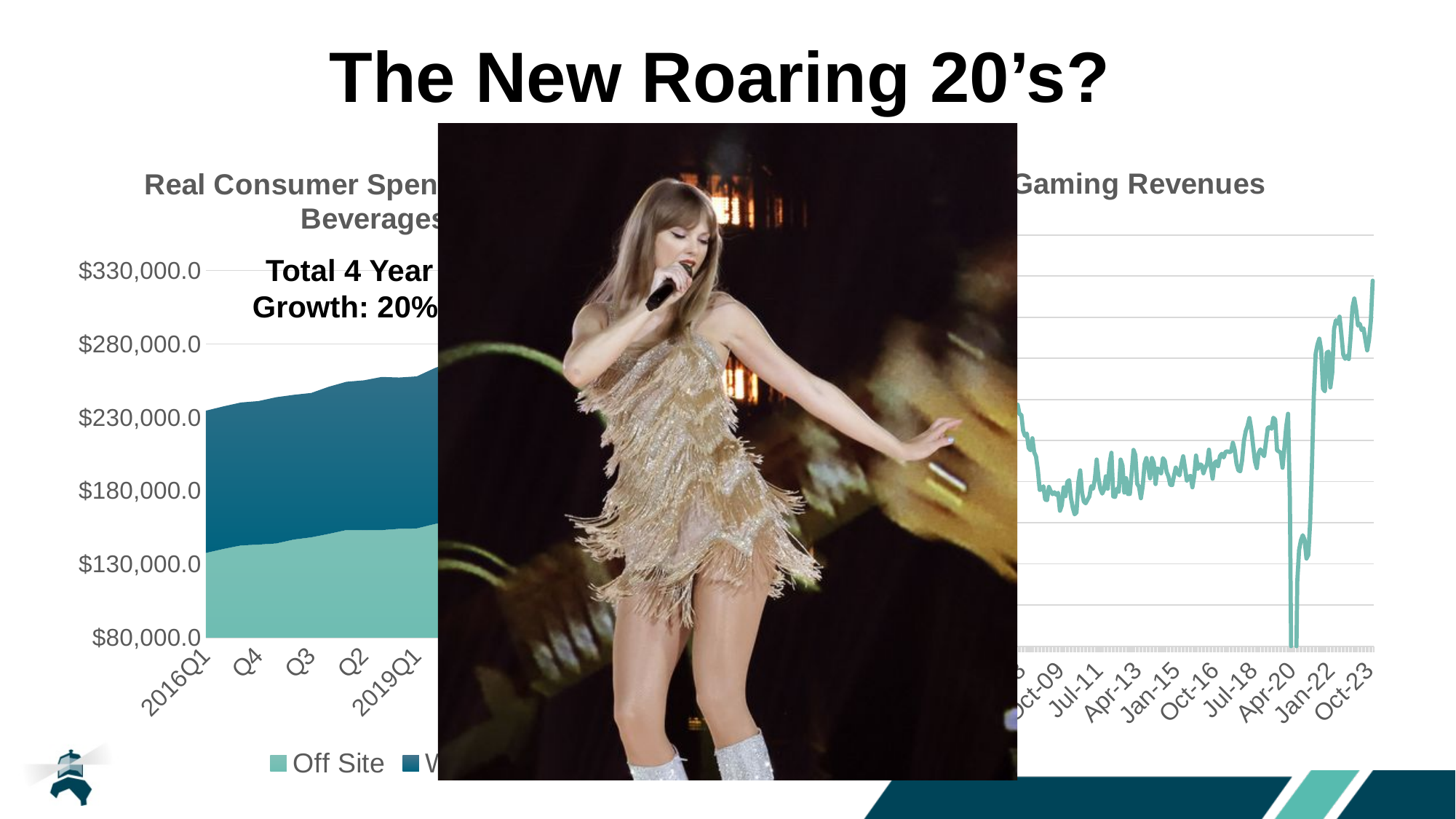
What kind of chart is the right chart (Gaming Revenues)? line chart On the right chart, does the line rise or fall sharply around Apr-20? fall What kind of chart is the left chart (Real Consumer Spending)? area chart On the right chart, does the line rise or fall from Apr-20 to Oct-23? rise On the left chart, what is the first legend entry shown? Off Site On the left chart, which is larger: the Off Site value at 2016Q1 or at 2019Q1? 2019Q1 On the left chart, is the Off Site value at 2016Q1 greater or less than $130,000.0? greater On the left chart, is the total stacked value at 2016Q1 greater or less than $280,000.0? less On the right chart, which is larger: the value at Oct-09 or the value at Oct-23? Oct-23 On the left chart, does the total stacked value rise or fall from 2016Q1 to 2019Q1? rise On the left chart, what total 4 year growth figure is printed on the chart? 20% On the right chart, what is the last x-axis label shown? Oct-23